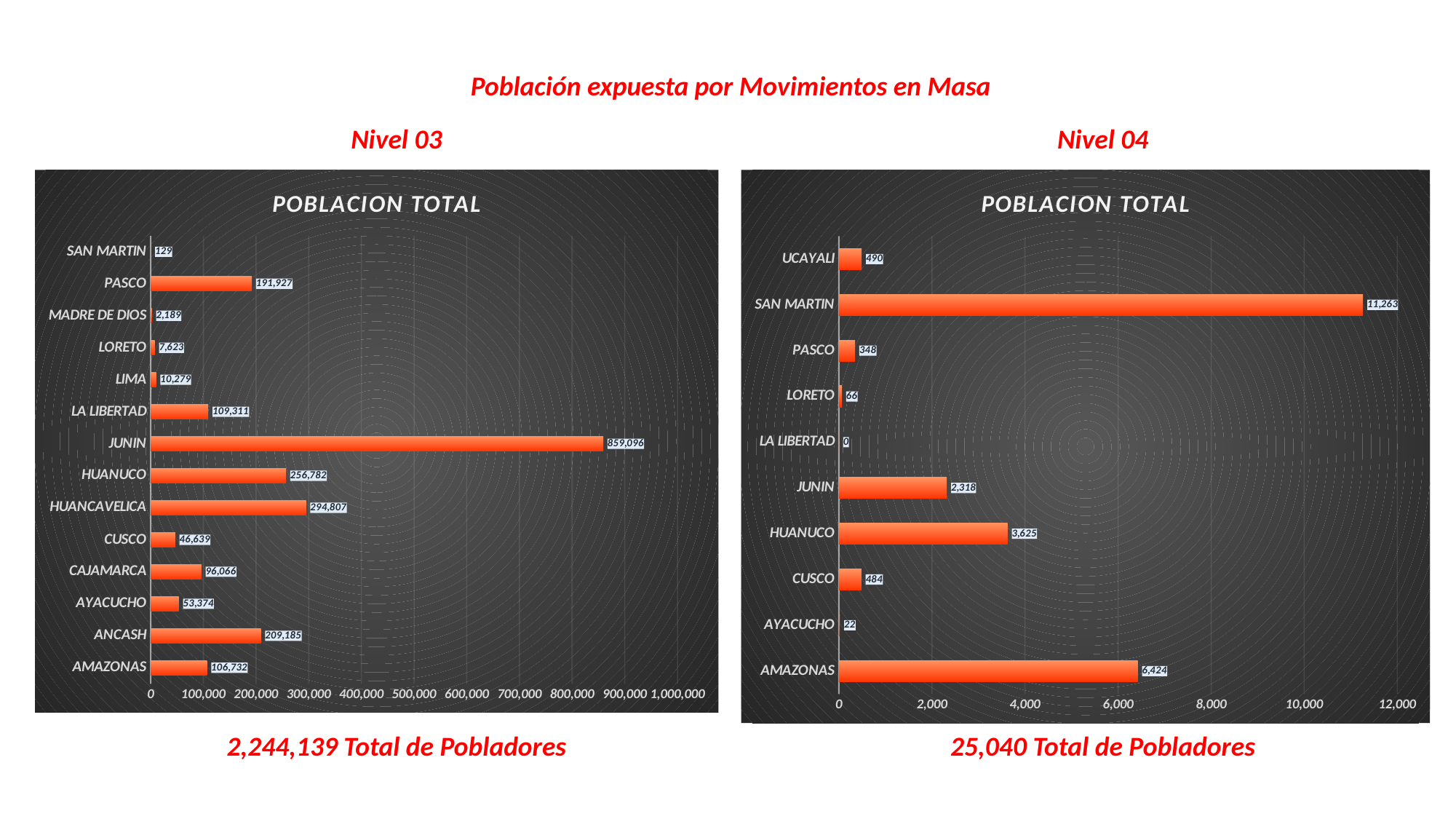
In the Nivel 03 chart on the left, how many categories are shown? 14 In the Nivel 04 chart on the right, which category has the highest value? SAN MARTIN In the Nivel 03 chart on the left, which is larger, PASCO or ANCASH? ANCASH In the Nivel 04 chart on the right, what is the difference between HUANUCO and JUNIN? 1,307 In the Nivel 04 chart on the right, what is the value for AMAZONAS? 6,424 In the Nivel 04 chart on the right, what is the value for LA LIBERTAD? 0 In the Nivel 03 chart on the left, what is the difference between HUANCAVELICA and HUANUCO? 38,025 What kind of chart is the Nivel 04 chart on the right? Bar chart In the Nivel 03 chart on the left, what is the value for CAJAMARCA? 96,066 In the Nivel 03 chart on the left, what is the value for JUNIN? 859,096 In the Nivel 04 chart on the right, how many categories are shown? 10 In the Nivel 03 chart on the left, which category has the lowest value? SAN MARTIN